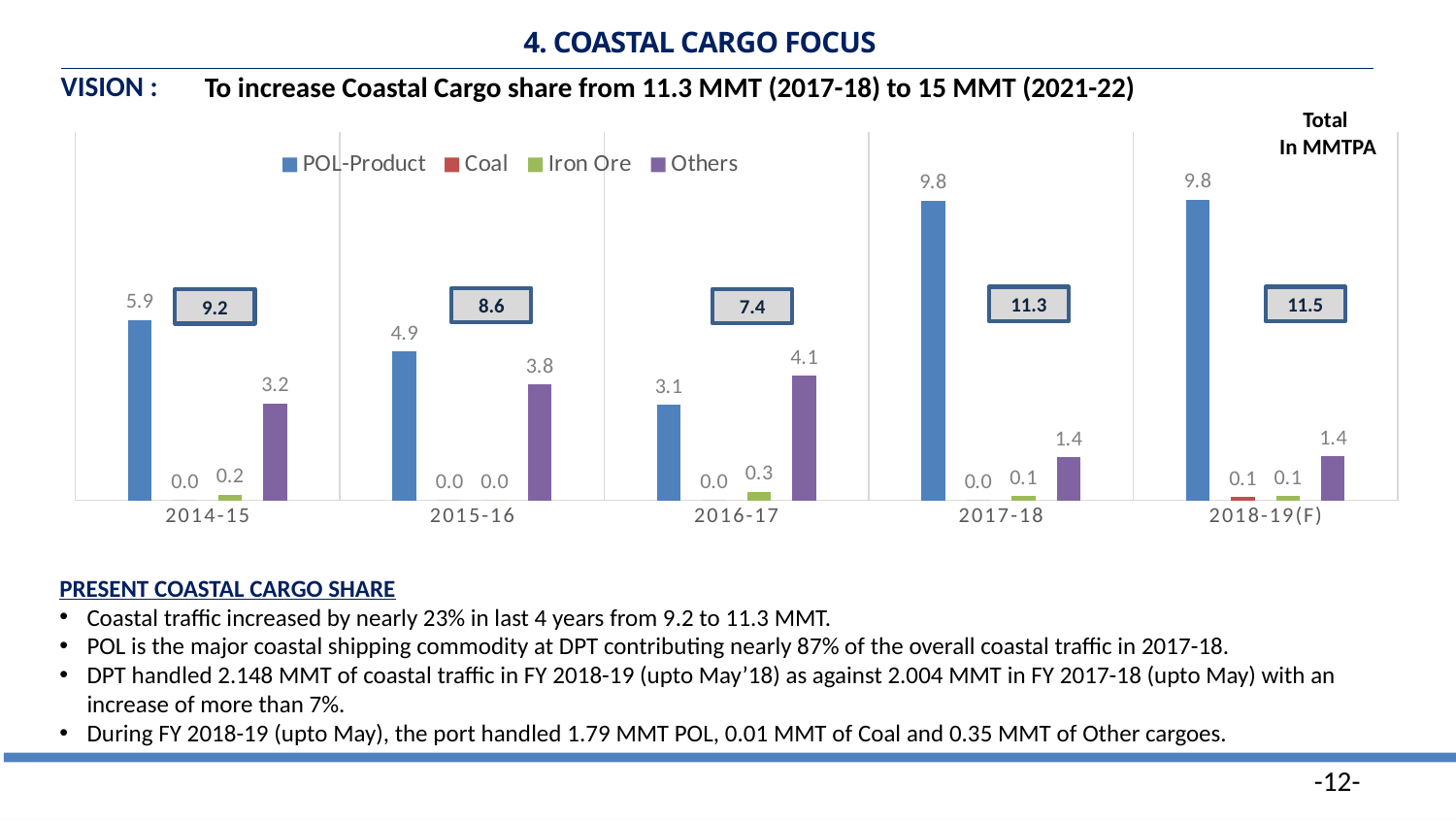
Which is larger, the Others value in 2015-16 or the Others value in 2017-18? 2015-16 What is the difference between the POL-Product values for 2014-15 and 2015-16? 1.0 What is the value for Coal in 2018-19(F)? 0.1 What is the value for POL-Product in 2017-18? 9.8 How many series does the chart legend list? 4 What kind of chart is shown on the slide? Bar chart What is the value for Iron Ore in 2014-15? 0.2 In which year is the Others value highest? 2016-17 In which year is the POL-Product value lowest? 2016-17 How many years are shown on the x axis of the chart? 5 What is the value for Others in 2016-17? 4.1 What total is shown in the box for 2017-18? 11.3